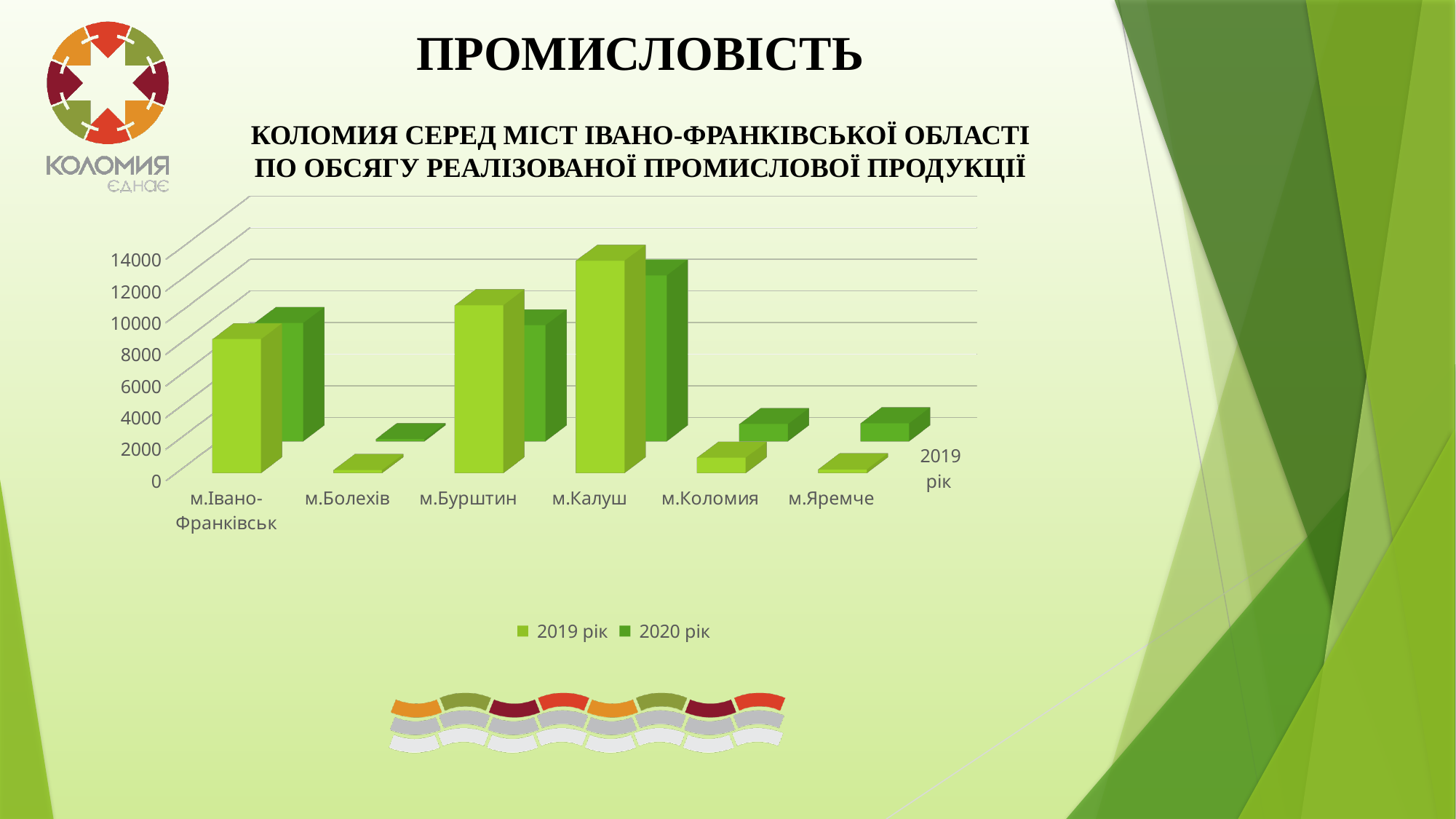
For м.Бурштин, which series is larger: 2019 рік or 2020 рік? 2019 рік Which city has the highest value for 2019 рік? м.Калуш Which city has the highest value for 2020 рік? м.Калуш Is the 2019 рік value for м.Калуш greater or less than 12000? greater Is the 2019 рік value for м.Коломия greater or less than 4000? less How many series does the chart legend list? 2 How many cities are shown on the x axis of the chart? 6 Is the 2019 рік value for м.Бурштин greater or less than 8000? greater Which is larger for 2019 рік: м.Калуш or м.Бурштин? м.Калуш Which city has the lowest value for 2020 рік? м.Болехів What kind of chart is shown on the slide? bar chart What are the two series named in the chart legend? 2019 рік and 2020 рік